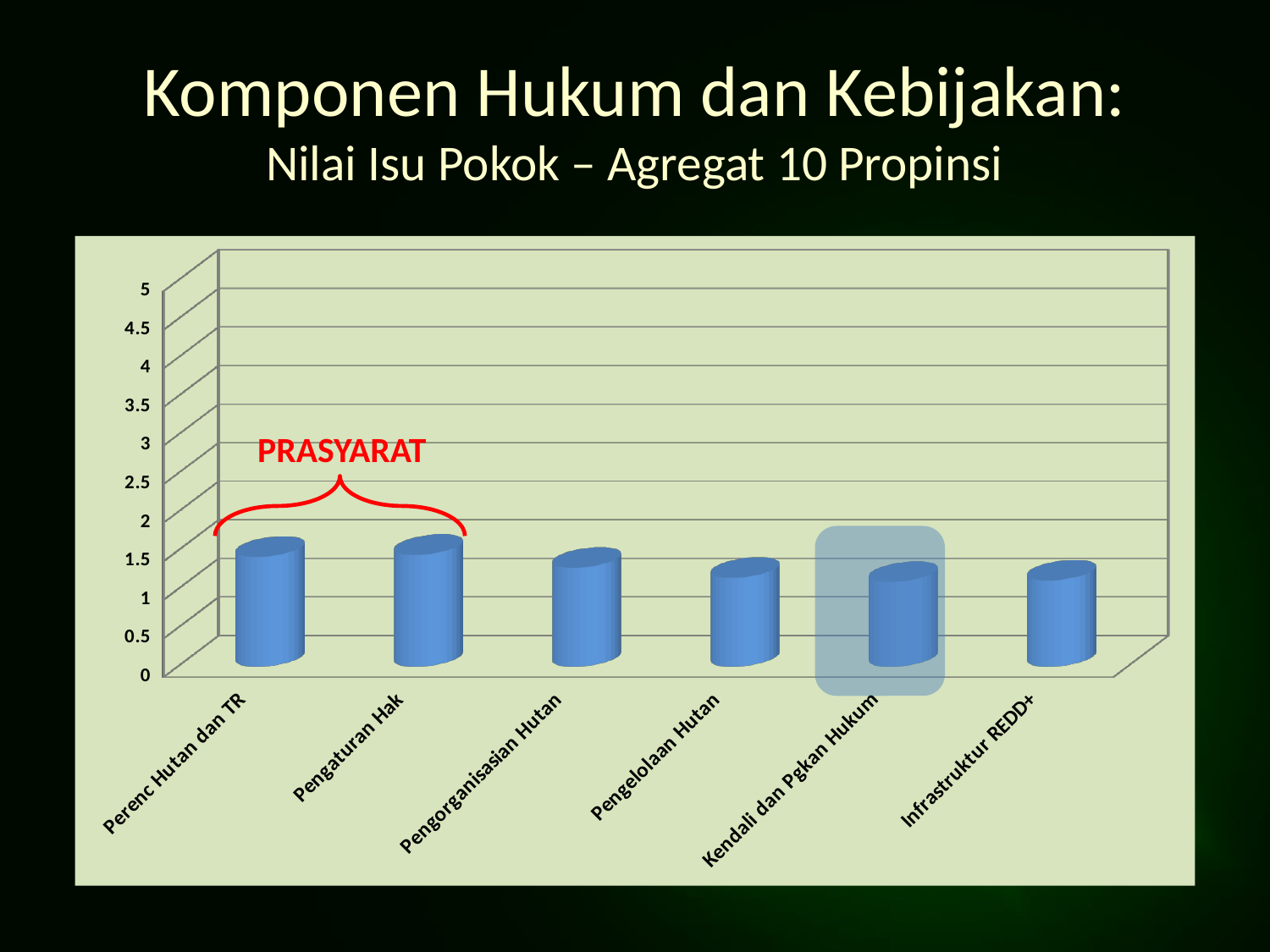
Is the value for Pengaturan Hak greater or less than 2? less Which is larger, the value for Perenc Hutan dan TR or the value for Infrastruktur REDD+? Perenc Hutan dan TR Is the value for Infrastruktur REDD+ greater or less than 1.5? less Is the value for Kendali dan Pgkan Hukum greater or less than 0.5? greater Do the values generally rise or fall moving from left to right along the x axis? fall Which is larger, the value for Pengaturan Hak or the value for Kendali dan Pgkan Hukum? Pengaturan Hak Which two categories are grouped under the red bracket labelled PRASYARAT? Perenc Hutan dan TR and Pengaturan Hak What is the highest value shown on the vertical axis? 5 How many categories are plotted on the chart? 6 What kind of chart is shown on the slide? bar chart